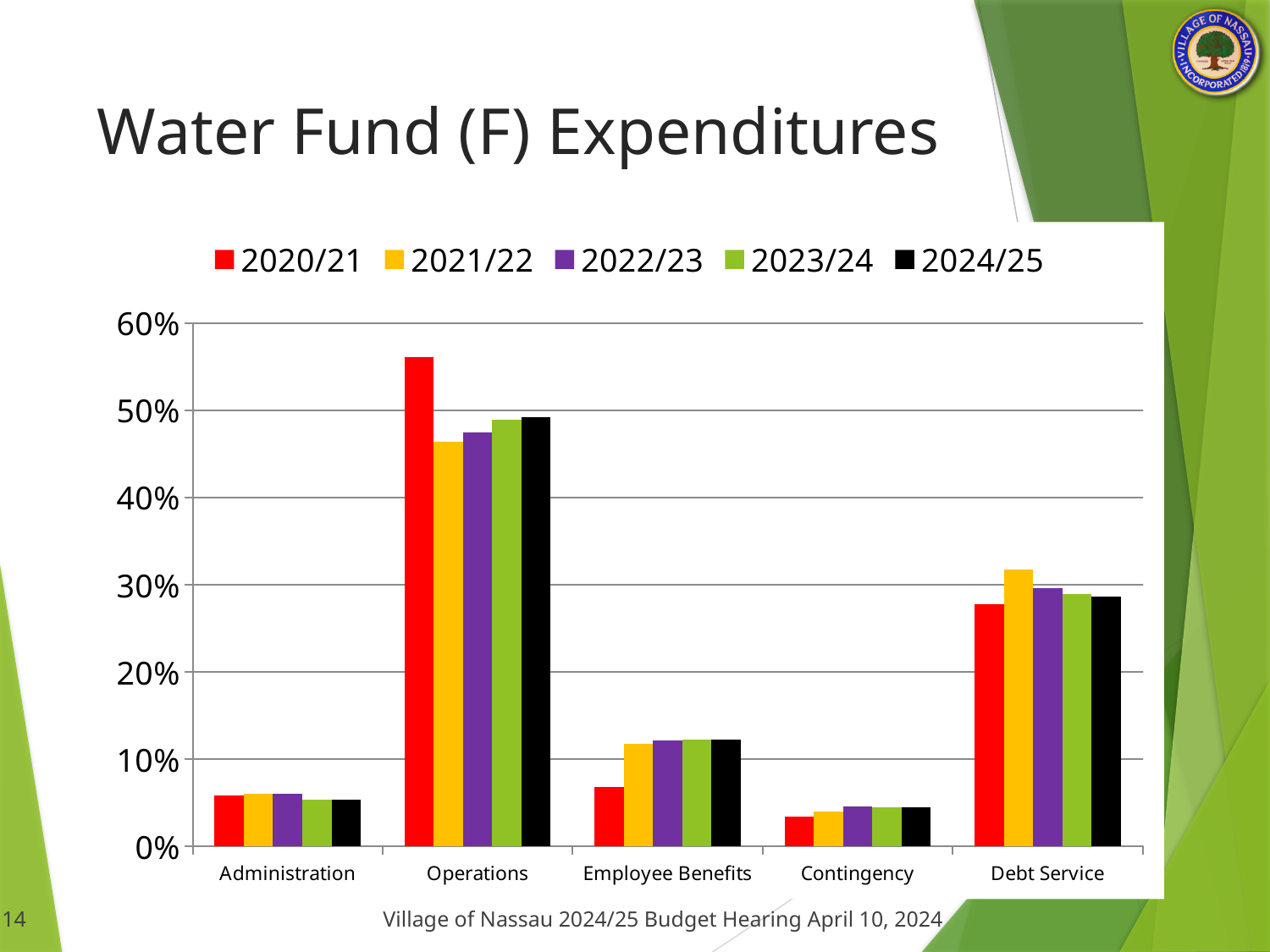
Is the Debt Service value for 2021/22 greater or less than 30%? greater Is the Operations value for 2021/22 greater or less than 50%? less For Debt Service, which is larger: the 2020/21 value or the 2021/22 value? 2021/22 Which category has the lowest value for 2024/25? Contingency Is the Operations value for 2020/21 greater or less than 50%? greater How many expenditure categories are shown on the x axis? 5 What colour represents the 2024/25 series in the legend? black What kind of chart is shown on the slide? bar chart How many series does the legend list? 5 For Operations, which is larger: the 2020/21 value or the 2024/25 value? 2020/21 Which category has the highest value for 2020/21? Operations